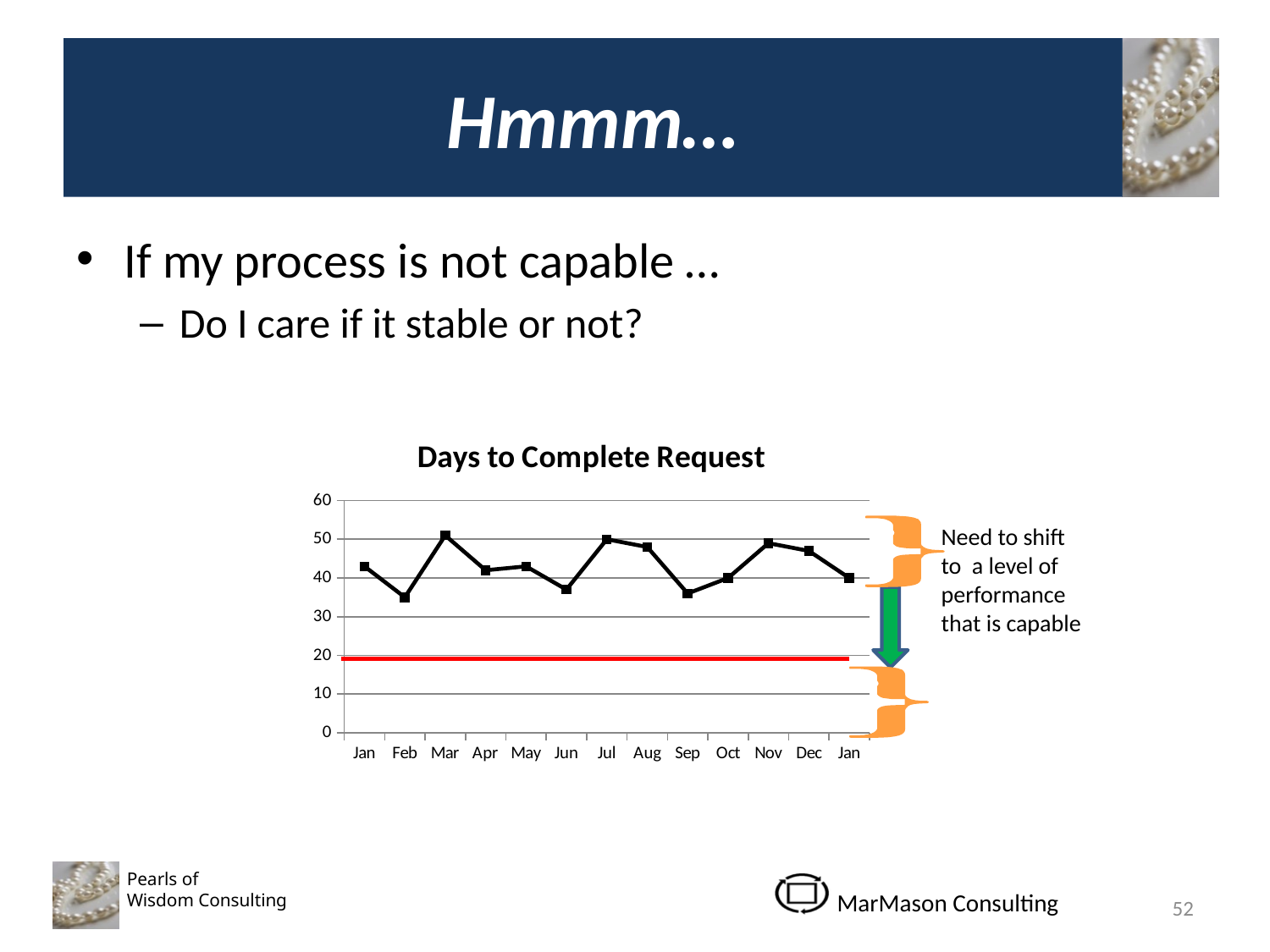
Is the value for Jul greater or less than 40? greater How many months are plotted along the x axis of the chart? 13 Which is larger, the value for Mar or the value for Feb? Mar What is the title of the chart? Days to Complete Request Does the line rise or fall from Jan to Feb? fall Is the value for Mar greater or less than 40? greater Which is larger, the value for Sep or the value for Nov? Nov Is the value for Jun greater or less than 30? greater What kind of chart is shown on the slide? line chart